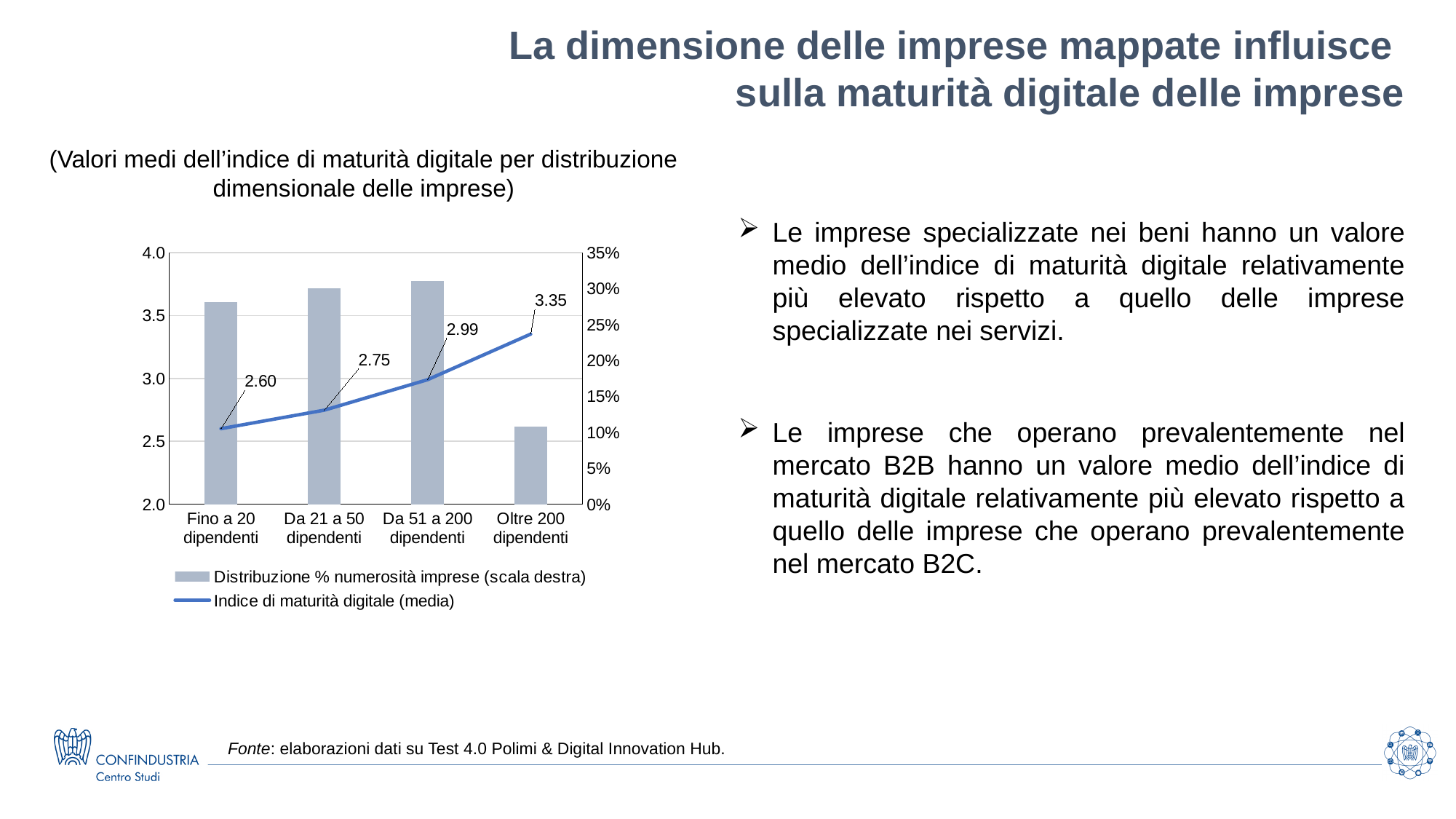
Which size class has the lowest bar for Distribuzione % numerosità imprese? Oltre 200 dipendenti Which size class has the lowest Indice di maturità digitale (media)? Fino a 20 dipendenti How many size classes are shown on the x axis of the chart? 4 Does the Indice di maturità digitale (media) rise or fall as company size increases along the x axis? rise What is the difference in the Indice di maturità digitale (media) between 'Oltre 200 dipendenti' and 'Fino a 20 dipendenti'? 0.75 Is the Distribuzione % numerosità imprese bar for 'Oltre 200 dipendenti' greater or less than 15%? less What is the value of the Indice di maturità digitale (media) for 'Oltre 200 dipendenti'? 3.35 What is the value of the Indice di maturità digitale (media) for 'Da 51 a 200 dipendenti'? 2.99 What is the value of the Indice di maturità digitale (media) for 'Fino a 20 dipendenti'? 2.60 Which has a higher Indice di maturità digitale (media): 'Da 21 a 50 dipendenti' or 'Da 51 a 200 dipendenti'? Da 51 a 200 dipendenti Is the Distribuzione % numerosità imprese bar for 'Da 21 a 50 dipendenti' greater or less than 25%? greater Which size class has the highest Indice di maturità digitale (media)? Oltre 200 dipendenti